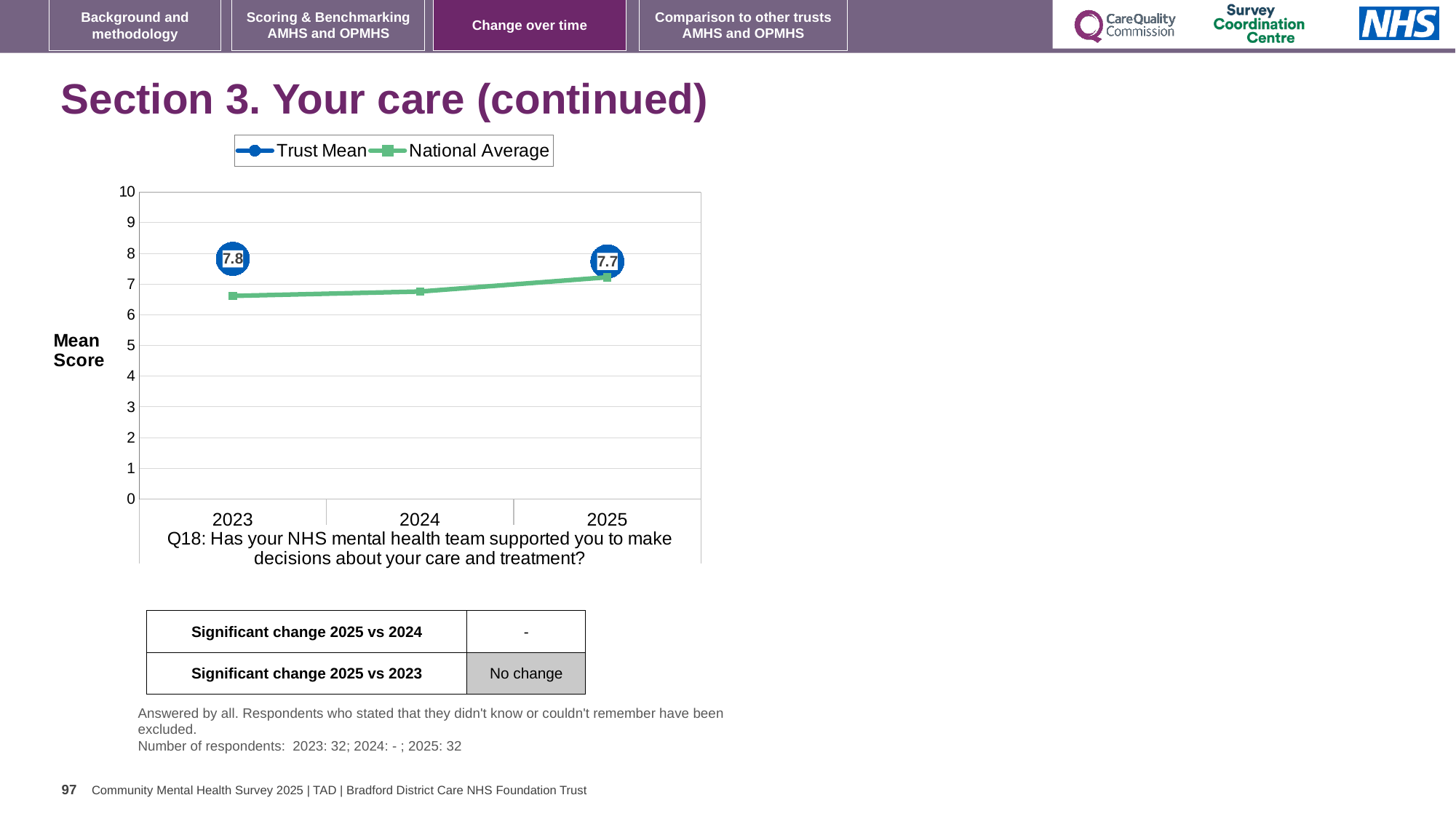
How many years are shown on the x axis of the chart? 3 Does the National Average rise or fall from 2023 to 2025? Rise What is the difference between the Trust Mean in 2023 and in 2025? 0.1 What is the label on the y axis of the chart? Mean Score What kind of chart is shown on the slide? Line chart Is the National Average value for 2023 greater or less than 7? less In 2023, which is higher, the Trust Mean or the National Average? Trust Mean What is the Trust Mean value for 2025? 7.7 Which year has the higher Trust Mean, 2023 or 2025? 2023 What is the Trust Mean value for 2023? 7.8 How many series does the chart legend list? 2 Is the National Average value for 2025 greater or less than 6? greater